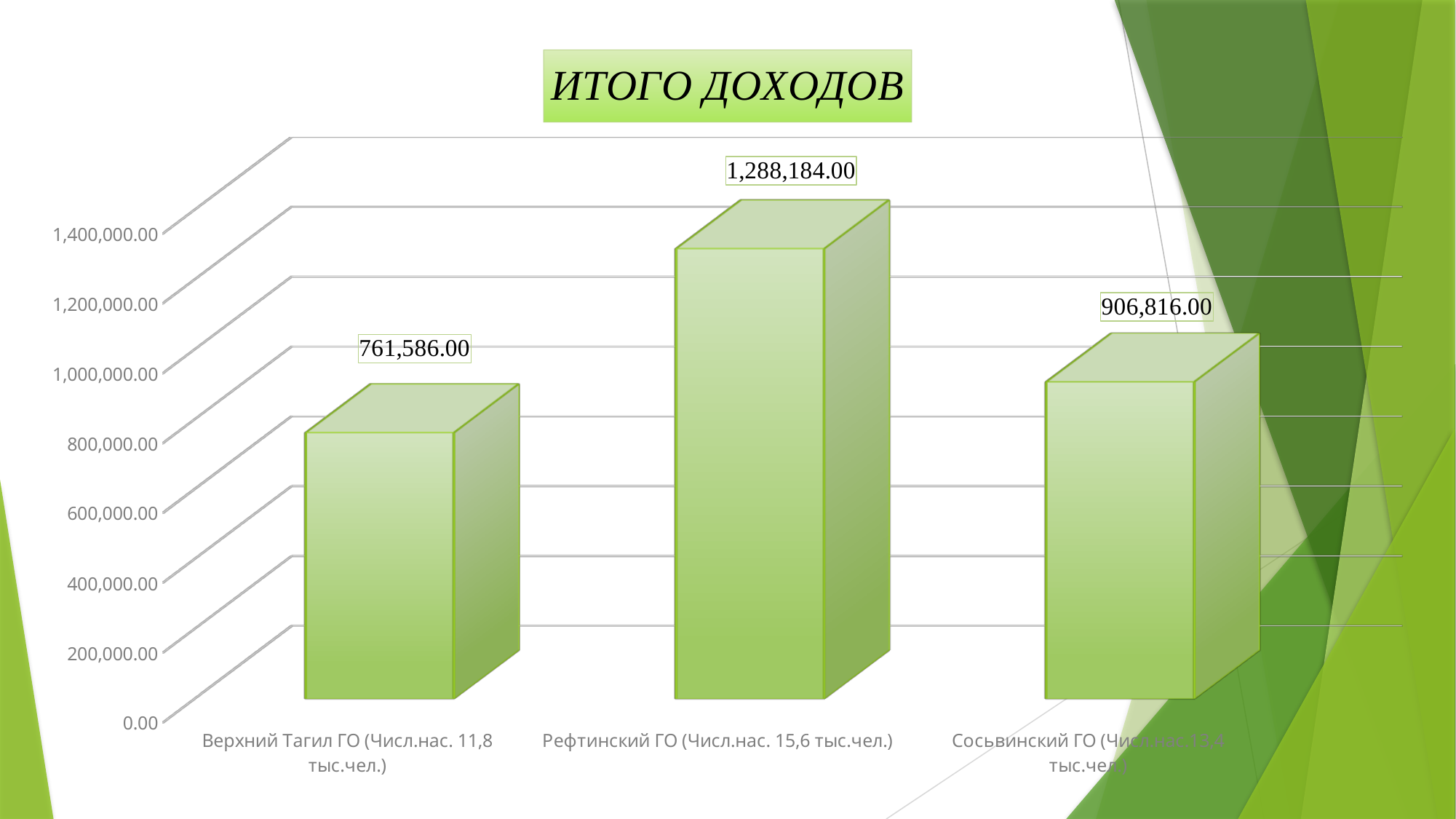
What is the value for Сосьвинский ГО? 906,816.00 Which is larger, the value for Сосьвинский ГО or the value for Верхний Тагил ГО? Сосьвинский ГО What is the value for Рефтинский ГО? 1,288,184.00 Is the value for Рефтинский ГО greater or less than 1,200,000.00? greater What is the difference between the values for Рефтинский ГО and Верхний Тагил ГО? 526,598.00 What kind of chart is shown on the slide? bar chart Which category has the lowest value? Верхний Тагил ГО Which category has the highest value? Рефтинский ГО What is the title of the chart? ИТОГО ДОХОДОВ How many categories are shown in the chart? 3 What is the value for Верхний Тагил ГО? 761,586.00 What is the difference between the values for Сосьвинский ГО and Верхний Тагил ГО? 145,230.00